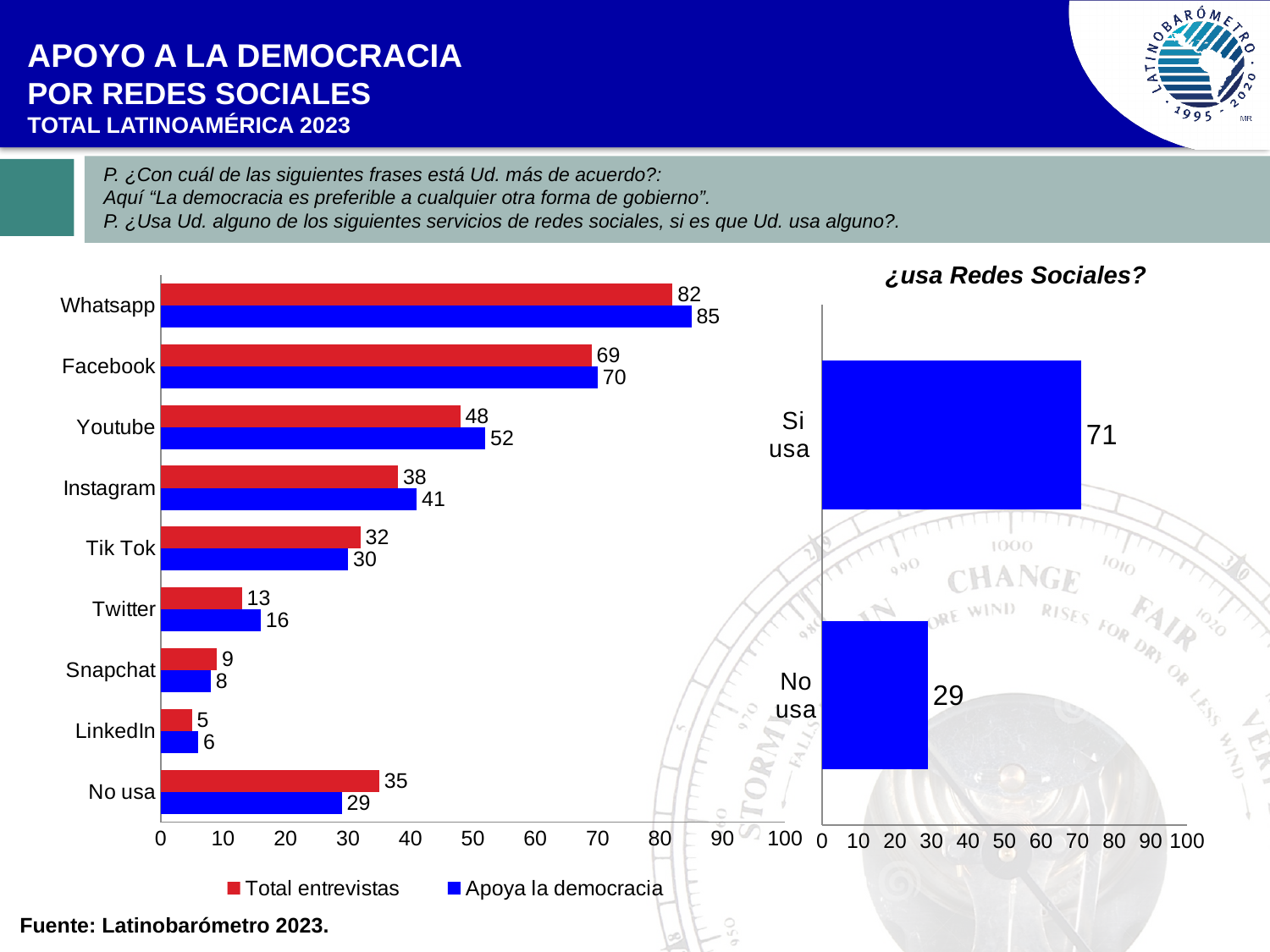
In the '¿usa Redes Sociales?' chart, what is the value for 'Si usa'? 71 What kind of chart is the '¿usa Redes Sociales?' chart? Bar chart In the left chart, what is the 'Total entrevistas' value for Facebook? 69 In the left chart, which is larger for Tik Tok: 'Total entrevistas' or 'Apoya la democracia'? Total entrevistas How many series does the legend of the left chart list? 2 In the '¿usa Redes Sociales?' chart, what is the difference between 'Si usa' and 'No usa'? 42 How many categories are shown in the left chart? 9 In the left chart, which category has the highest 'Total entrevistas' value? Whatsapp In the left chart, which category has the lowest 'Apoya la democracia' value? LinkedIn In the left chart, what is the value for Whatsapp in the 'Apoya la democracia' series? 85 In the left chart, what is the difference between the 'Total entrevistas' and 'Apoya la democracia' values for No usa? 6 In the left chart, what colour are the 'Apoya la democracia' bars? Blue